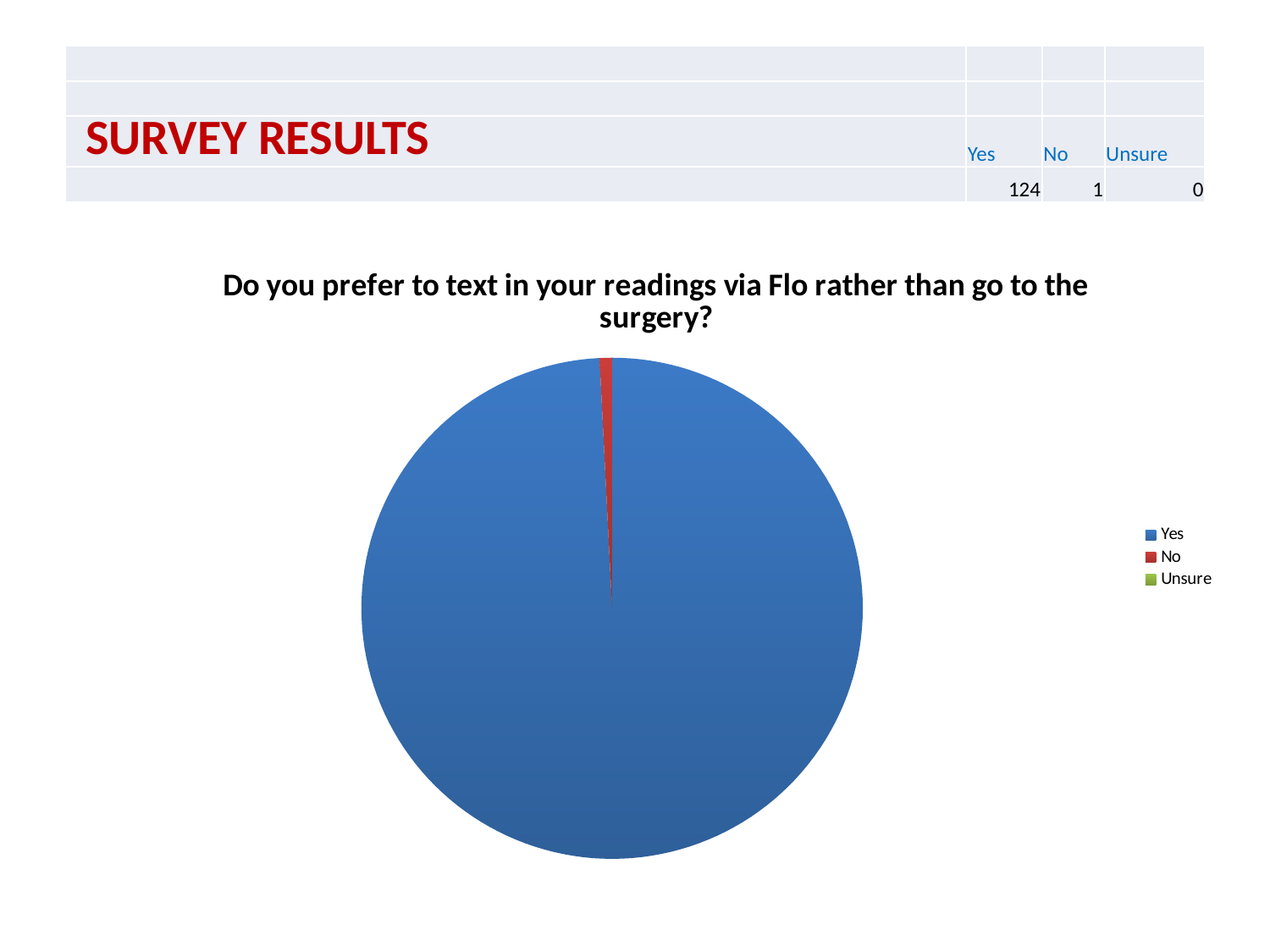
How many respondents answered Yes? 124 Which is larger, the number of No responses or the number of Unsure responses? No How many respondents answered No? 1 How many respondents answered Unsure? 0 What is the difference between the number of Yes and No responses? 123 What colour is the Yes slice in the pie chart? blue How many categories does the legend of the pie chart list? 3 What kind of chart is shown on the slide? pie chart Which category has the smallest value in the survey results? Unsure What is the title of the pie chart? Do you prefer to text in your readings via Flo rather than go to the surgery? What is the total number of responses shown in the survey results? 125 Which category has the largest slice of the pie chart? Yes